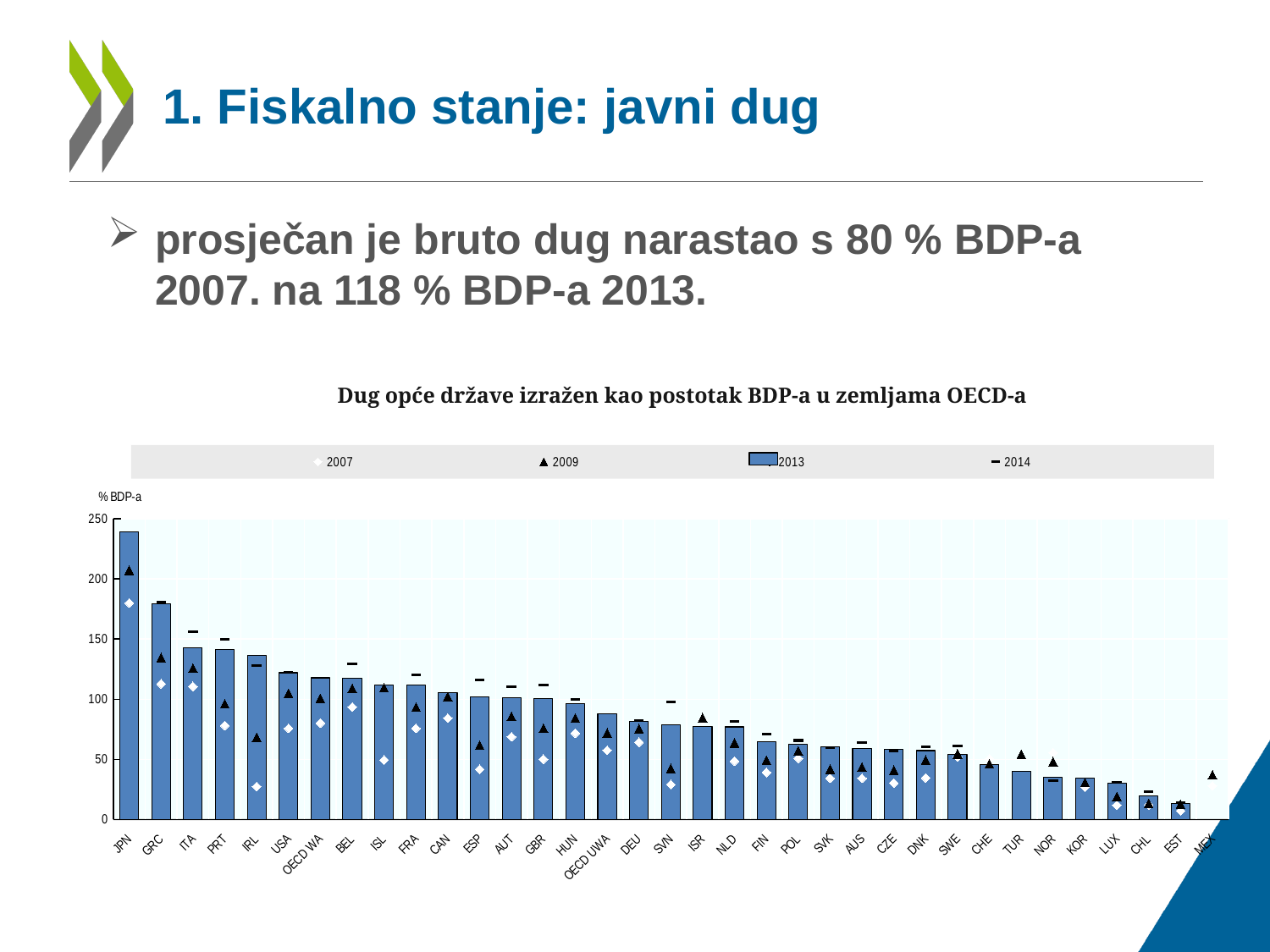
Is the 2013 value for USA greater or less than 100? greater Is the 2013 value for DEU greater or less than 100? less Is the 2013 value for GRC greater or less than 150? greater Which has the larger 2013 bar, USA or DEU? USA What kind of chart is shown on the slide? bar chart Do the 2013 bars rise or fall from left to right along the x axis? fall Which has the larger 2013 bar, JPN or GRC? JPN Which country has the highest 2013 bar in the chart? JPN How many series does the chart legend list? 4 What is the title of the chart? Dug opće države izražen kao postotak BDP-a u zemljama OECD-a